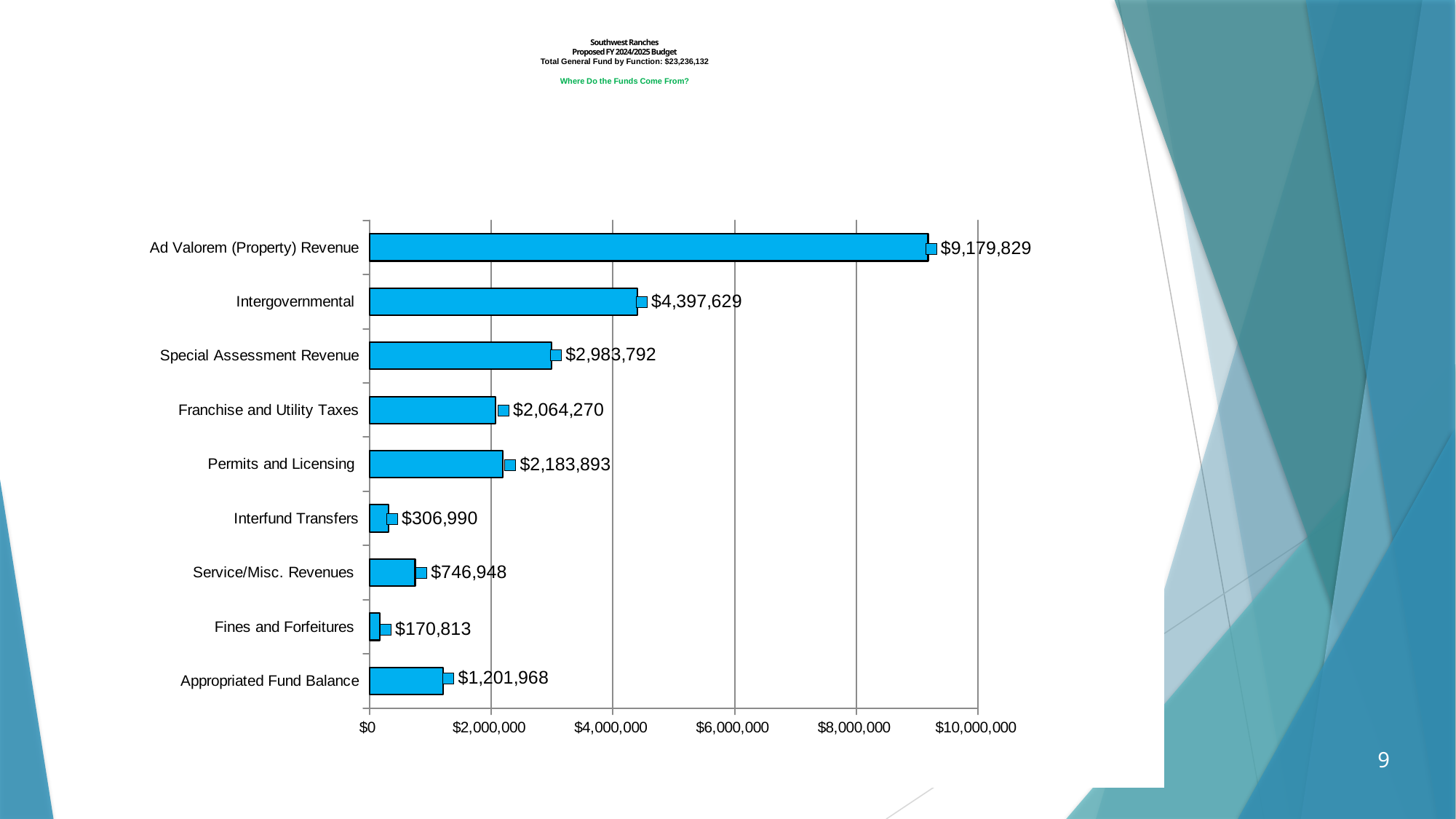
Is the value for Intergovernmental greater or less than $4,000,000? greater What is the value for Intergovernmental? $4,397,629 How many categories are shown in the chart? 9 What is the value for Ad Valorem (Property) Revenue? $9,179,829 Which category has the highest value? Ad Valorem (Property) Revenue Which is larger, Special Assessment Revenue or Intergovernmental? Intergovernmental Which category has the lowest value? Fines and Forfeitures What kind of chart is shown on the slide? bar chart What is the difference between Service/Misc. Revenues and Interfund Transfers? $439,958 What is the value for Appropriated Fund Balance? $1,201,968 What is the difference between Ad Valorem (Property) Revenue and Intergovernmental? $4,782,200 What is the value for Fines and Forfeitures? $170,813